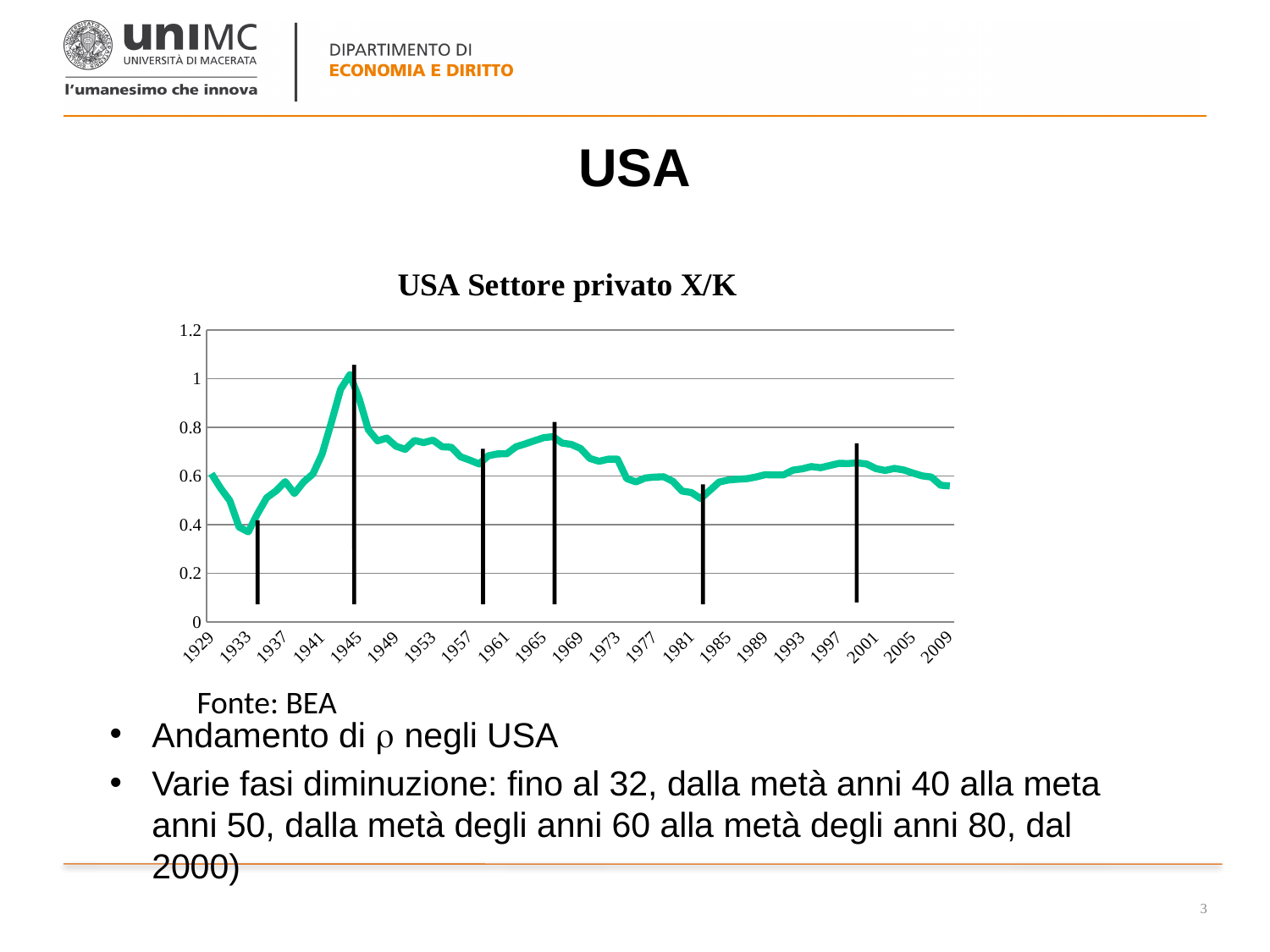
Is the value for 2009 greater or less than 0.6? less What kind of chart is shown on the slide? line chart Is the value for 1945 greater or less than 0.8? greater What is the highest value shown on the y axis? 1.2 What source is cited below the chart? Fonte: BEA Is the value for 1965 greater or less than 0.6? greater Does the line rise or fall between 1937 and 1945? rise Which is larger, the value for 1945 or the value for 1981? 1945 What is the title of the chart? USA Settore privato X/K Does the line rise or fall between 1929 and 1933? fall